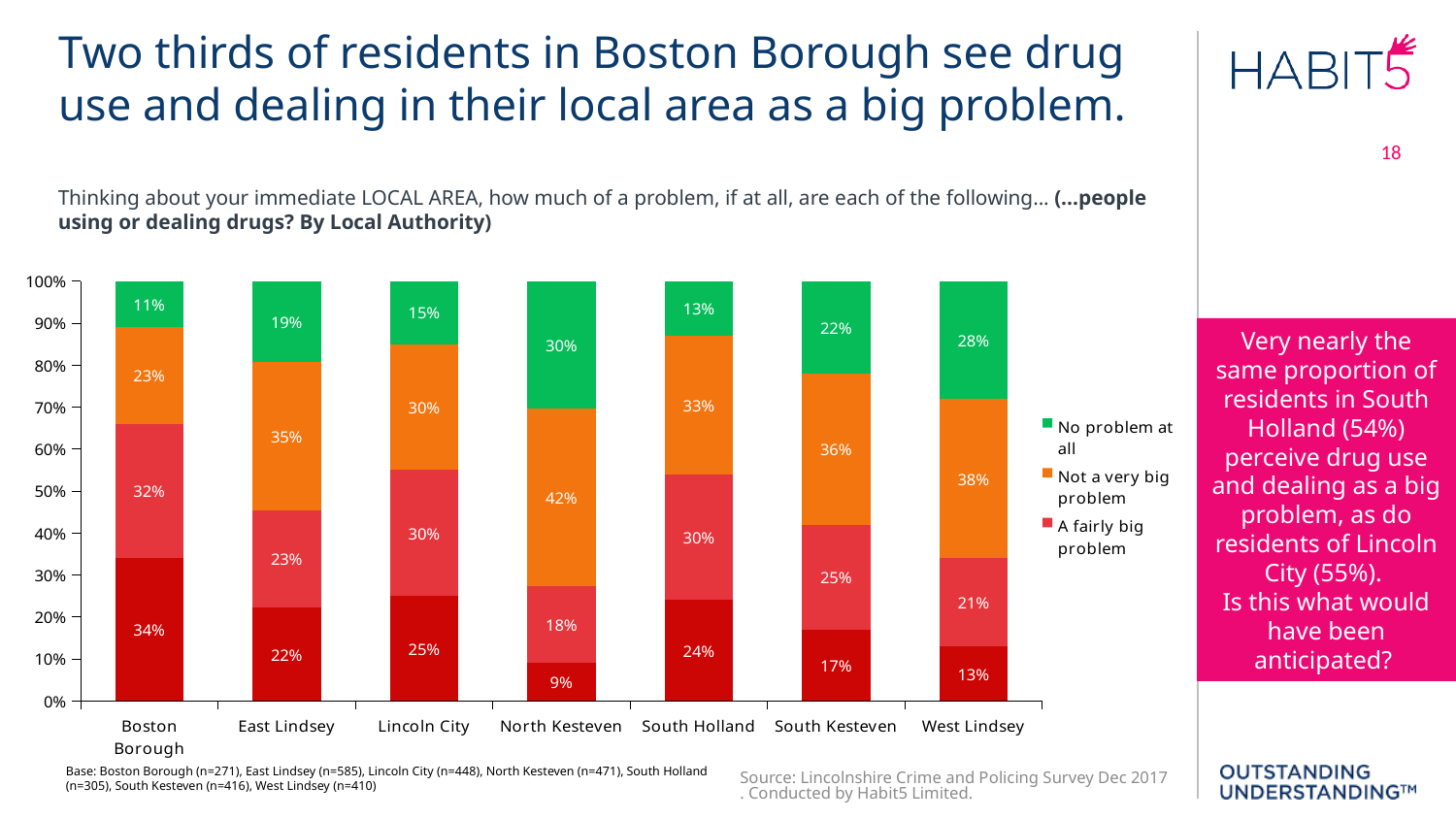
Which local authority has the highest 'Not a very big problem' value? North Kesteven Which local authority has the lowest 'No problem at all' value? Boston Borough What colour represents 'No problem at all' in the chart legend? Green What percentage of North Kesteven residents say drug use and dealing is 'No problem at all'? 30% How many local authorities are shown on the x axis of the chart? 7 What is the 'Not a very big problem' value for West Lindsey? 38% What percentage of Boston Borough residents say people using or dealing drugs is 'A fairly big problem'? 32% Which has the larger 'No problem at all' value, East Lindsey or Lincoln City? East Lindsey What kind of chart is shown on the slide? Stacked bar chart Which local authority has the highest 'A fairly big problem' value? Boston Borough How many percentage points higher is the 'Not a very big problem' value for North Kesteven than for Boston Borough? 19 percentage points What is the combined percentage of 'Not a very big problem' and 'No problem at all' for South Holland? 46%